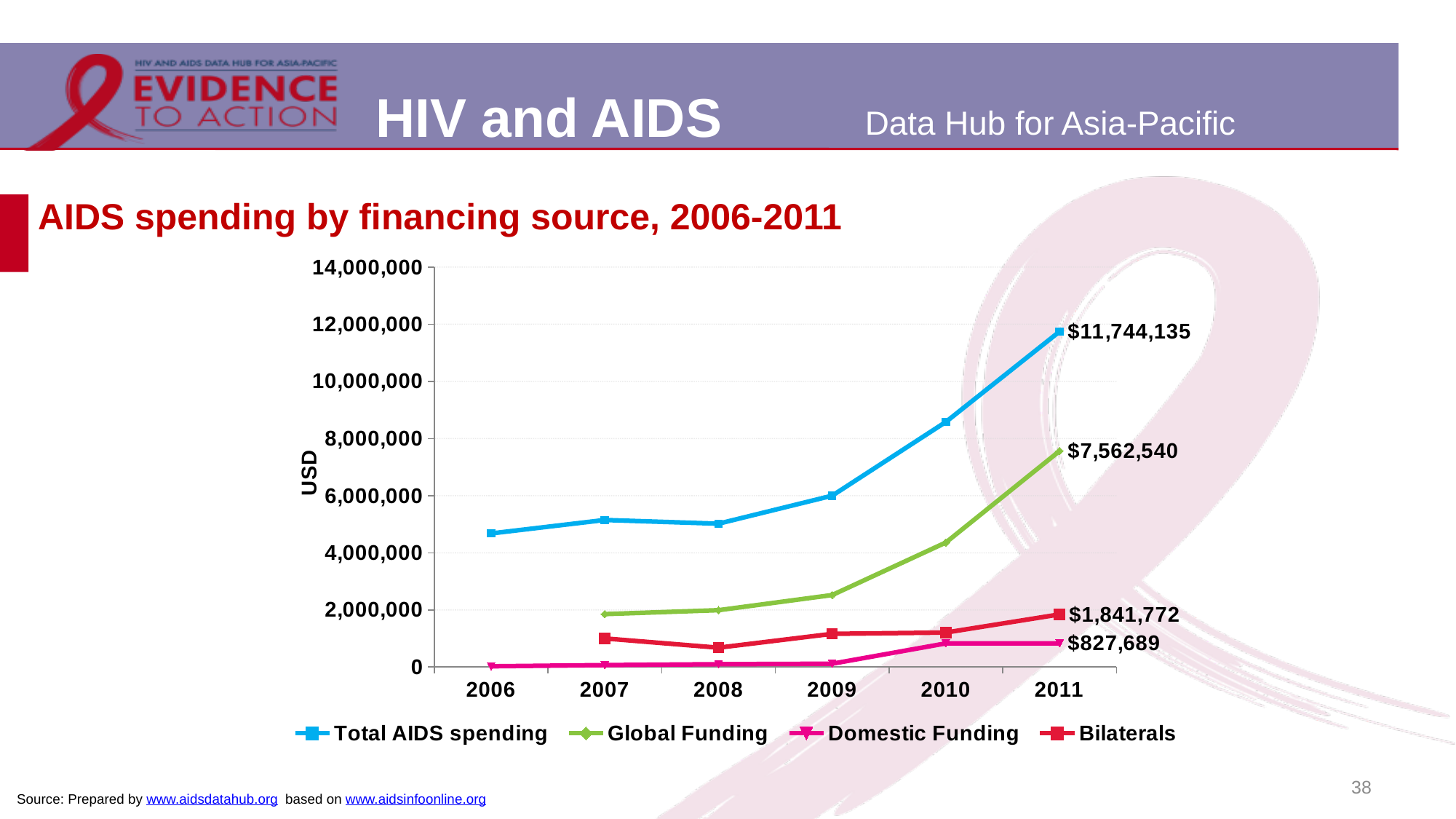
Is the value for Global Funding in 2009 greater or less than 4,000,000? less Which series has the lowest value in 2011? Domestic Funding Which is larger in 2011, Bilaterals or Domestic Funding? Bilaterals What is the value for Total AIDS spending in 2011? $11,744,135 How many series does the legend list? 4 What is the value for Domestic Funding in 2011? $827,689 What is the value for Global Funding in 2011? $7,562,540 What is the difference between Total AIDS spending and Global Funding in 2011? $4,181,595 Is the value for Total AIDS spending in 2006 greater or less than 4,000,000? greater What is the value for Bilaterals in 2011? $1,841,772 What kind of chart is shown on the slide? line chart How many years are shown on the x axis? 6